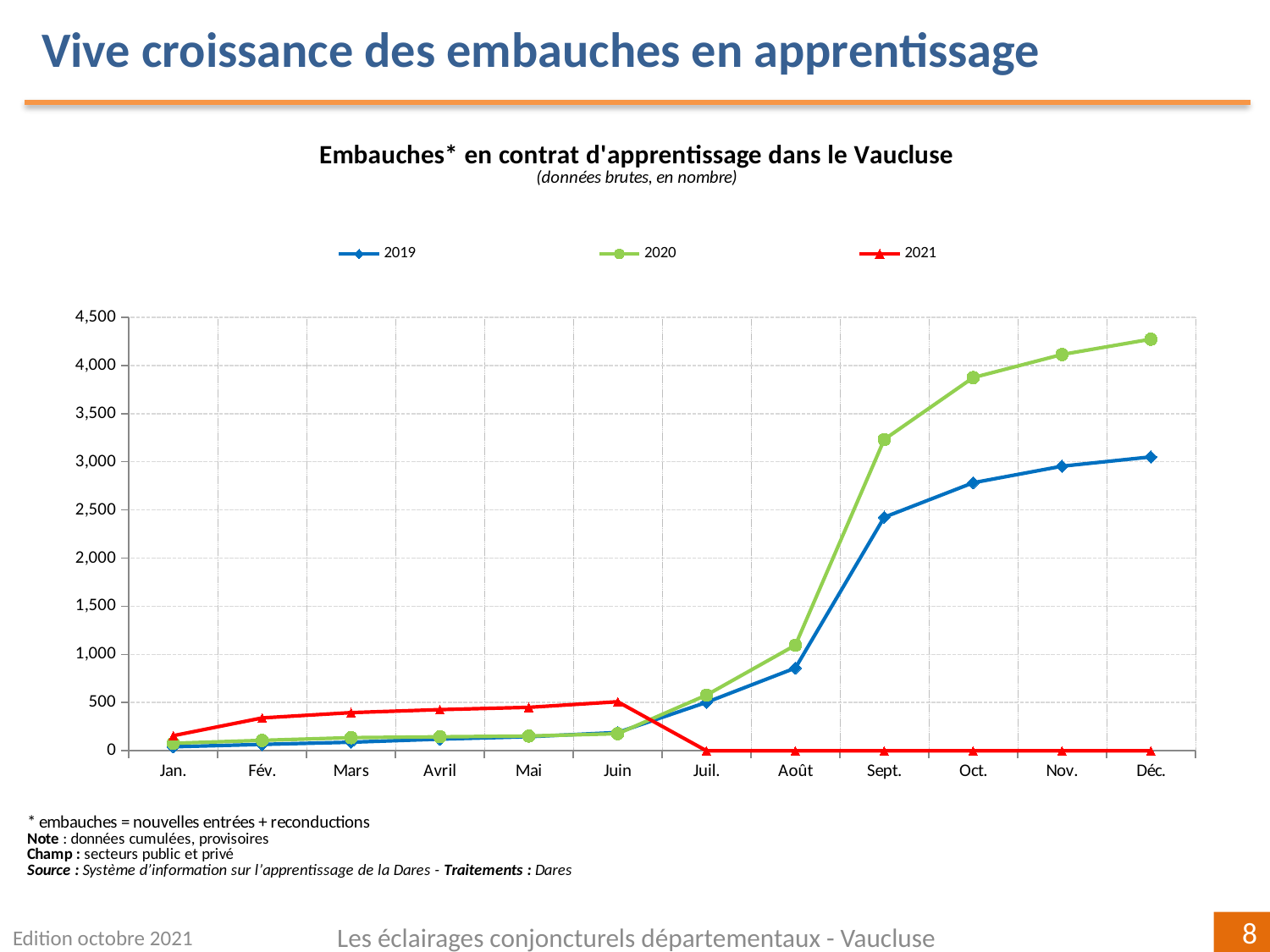
What kind of chart is shown on the slide? line chart Does the 2020 series rise or fall from Jan. to Déc.? rise In Mars, which series has the larger value, 2019 or 2021? 2021 In Déc., which series has the larger value, 2019 or 2020? 2020 How many series does the legend list? 3 How many months are shown along the x axis? 12 Is the value for 2019 in Août greater or less than 1,000? less Is the value for 2020 in Déc. greater or less than 4,000? greater In which month does the 2020 series reach its highest value? Déc. Is the value for 2019 in Oct. greater or less than 2,500? greater In which month is the 2019 series at its lowest value? Jan.